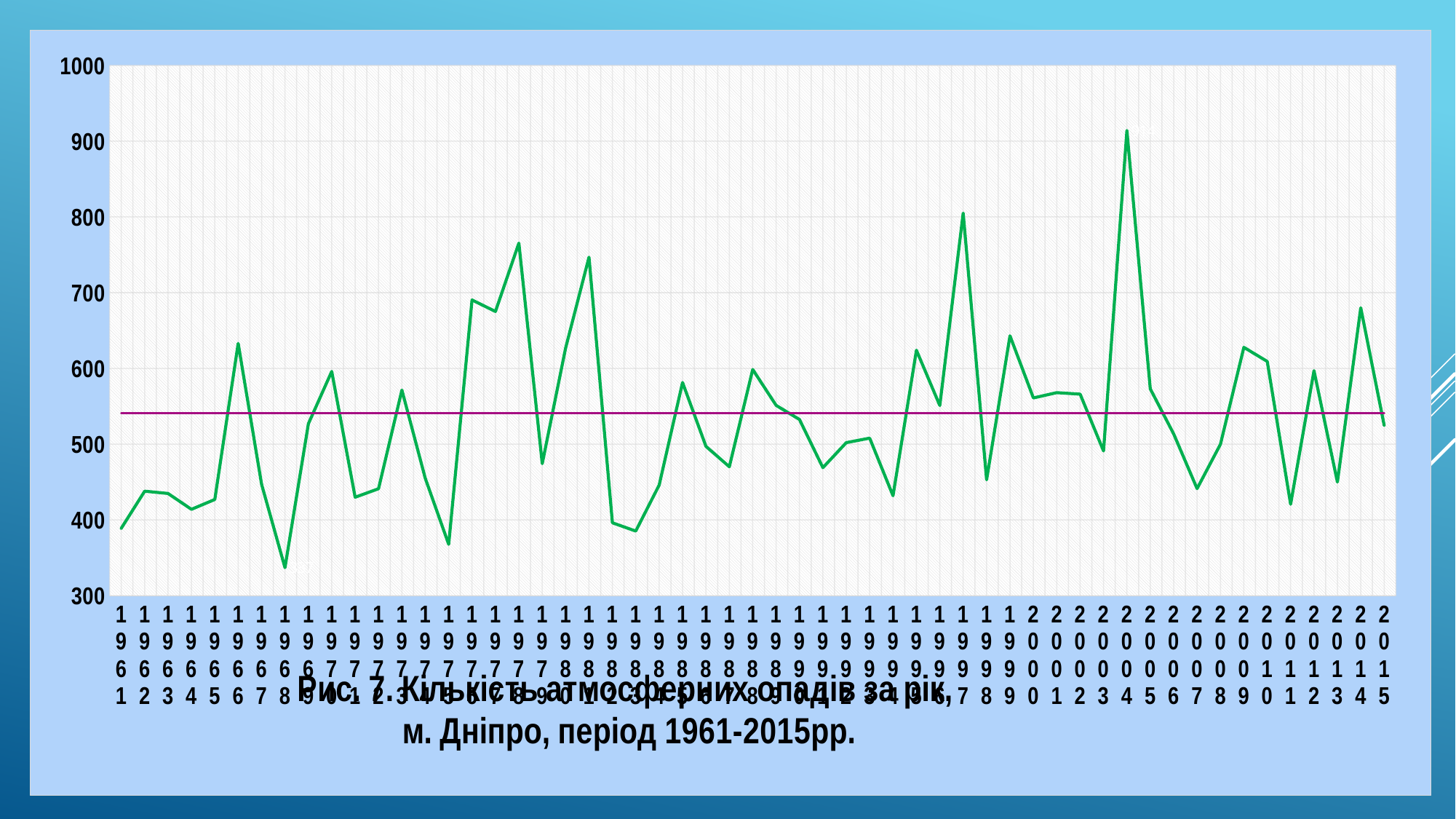
Which year has the lowest annual precipitation value on the chart? 1968 According to the caption, which city does the chart describe? м. Дніпро Which year has the larger value, 1966 or 2014? 2014 Is the value for 1968 greater or less than 400? less Is the value for 1978 greater or less than 700? greater What kind of chart is shown on the slide? line chart Is the value for 2004 greater or less than 900? greater How many years are plotted along the x axis of the chart? 55 Which year has the larger value, 2004 or 1997? 2004 Which year has the highest annual precipitation value on the chart? 2004